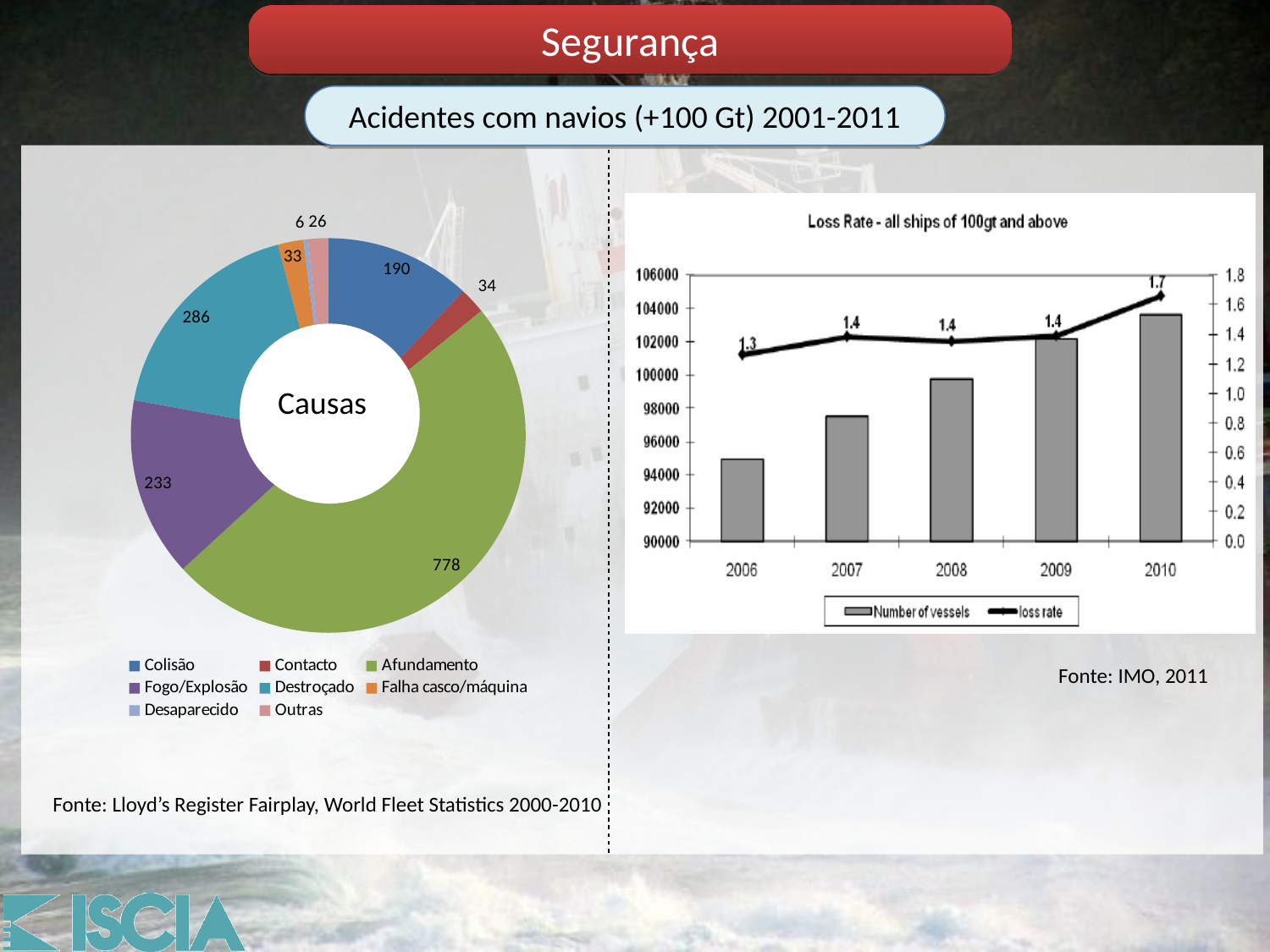
In the Causas chart, what is the difference between the values for Destroçado and Fogo/Explosão? 53 In the Causas chart, which cause has the highest value? Afundamento In the Causas chart, which is larger: Colisão or Fogo/Explosão? Fogo/Explosão In the Causas chart, what is the value for Afundamento? 778 In the Loss Rate chart, what is the loss rate for 2010? 1.7 In the Loss Rate chart, does the number of vessels rise or fall from 2006 to 2010? rise In the Loss Rate chart, what is the loss rate for 2006? 1.3 In the Causas chart, which cause has the lowest value? Desaparecido In the Loss Rate chart, is the number of vessels for 2006 greater or less than 96000? less In the Causas chart, what is the value for Destroçado? 286 What kind of chart is the Causas chart? Doughnut (pie) chart How many categories does the Causas chart show? 8